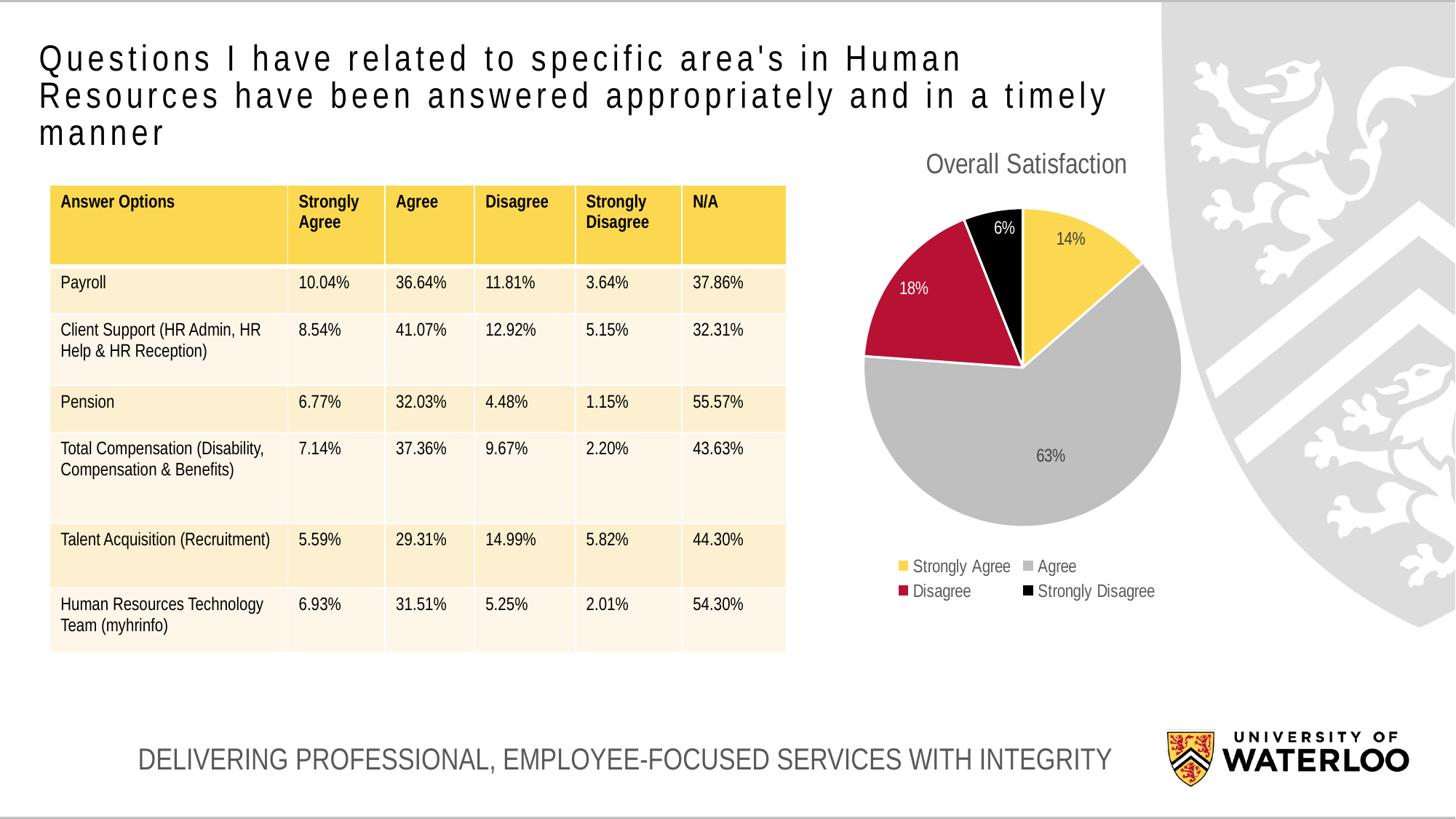
How many slices does the Overall Satisfaction pie chart have? 4 Which slice is the smallest in the Overall Satisfaction pie chart? Strongly Disagree In the Overall Satisfaction pie chart, which is larger: Disagree or Strongly Agree? Disagree In the Overall Satisfaction pie chart, what share is labelled for Disagree? 18% In the Overall Satisfaction pie chart, what share is labelled for Agree? 63% What colour is the Disagree slice in the Overall Satisfaction pie chart? red In the Overall Satisfaction pie chart, what is the difference between the Agree and Disagree shares? 45% In the Overall Satisfaction pie chart, what share is labelled for Strongly Disagree? 6% What type of chart is the Overall Satisfaction chart? pie chart In the Overall Satisfaction pie chart, what share is labelled for Strongly Agree? 14% Which slice is the largest in the Overall Satisfaction pie chart? Agree How many entries does the legend of the Overall Satisfaction pie chart list? 4